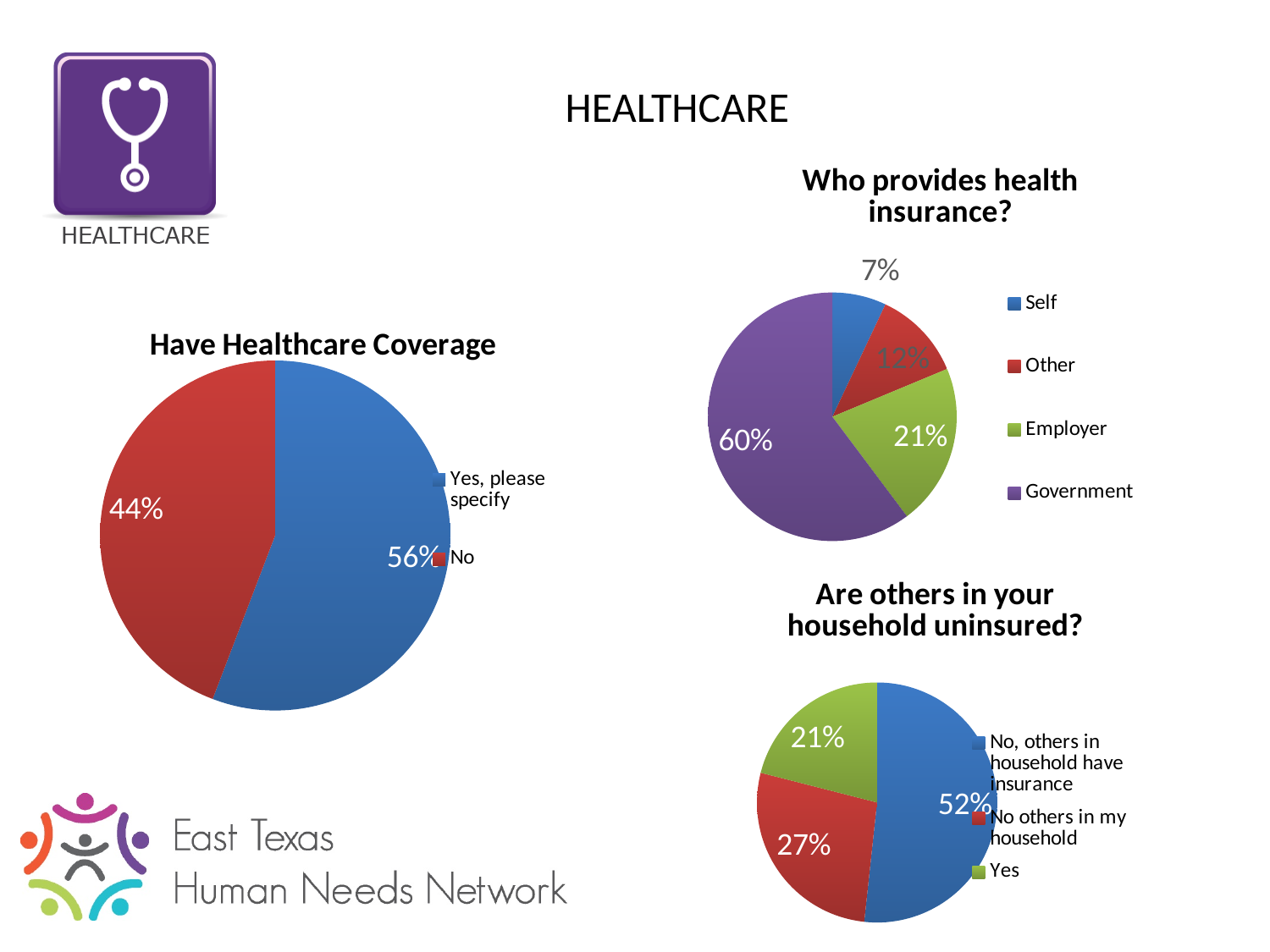
In the 'Who provides health insurance?' chart, what is the difference between the 'Employer' and 'Other' shares? 9% In the 'Who provides health insurance?' chart, which category has the smallest share? Self In the 'Who provides health insurance?' chart, which category has the largest share? Government In the 'Have Healthcare Coverage' chart, what is the difference between the 'Yes, please specify' and 'No' shares? 12% In the 'Are others in your household uninsured?' chart, what share answered 'Yes'? 21% In the 'Who provides health insurance?' chart, how many categories does the legend list? 4 In the 'Have Healthcare Coverage' chart, what share of respondents answered 'No'? 44% In the 'Who provides health insurance?' chart, what share is 'Employer'? 21% In the 'Are others in your household uninsured?' chart, which is larger: 'No others in my household' or 'Yes'? No others in my household What kind of chart is the 'Are others in your household uninsured?' chart? Pie chart